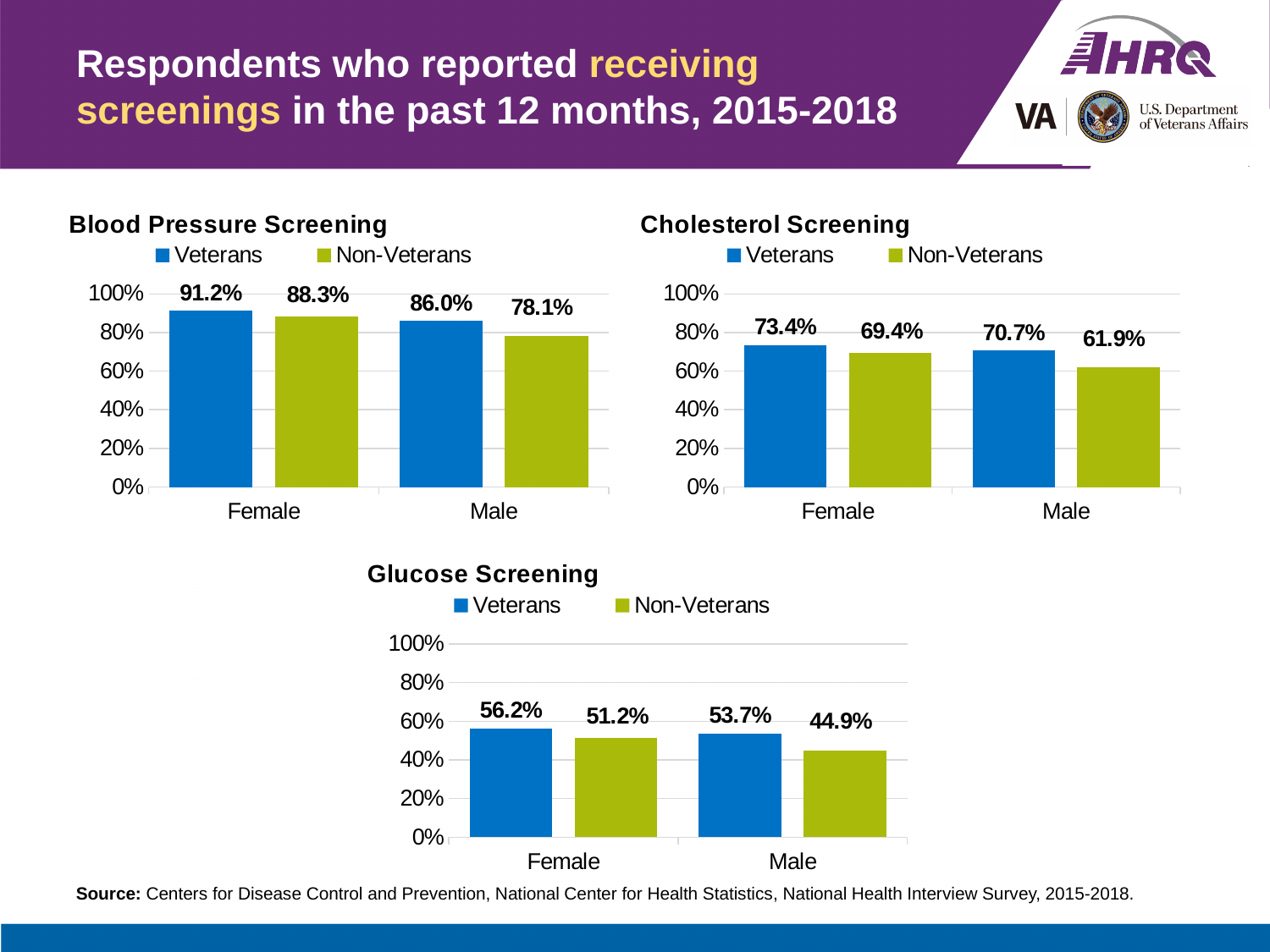
How many charts are shown on the slide? 3 In the Blood Pressure Screening chart, what is the value for Female Veterans? 91.2% In the Glucose Screening chart, what is the value for Female Non-Veterans? 51.2% In the Blood Pressure Screening chart, which bar has the lowest value? Male Non-Veterans In the Glucose Screening chart, is the value for Male Non-Veterans greater or less than 60%? less How many series does the legend of the Cholesterol Screening chart list? 2 In the Cholesterol Screening chart, which is larger: Female Non-Veterans or Male Veterans? Male Veterans In the Blood Pressure Screening chart, what is the difference between Female Veterans and Female Non-Veterans? 2.9% What kind of chart is the Glucose Screening chart? Bar chart In the Cholesterol Screening chart, which bar has the highest value? Female Veterans In the Glucose Screening chart, what is the difference between Male Veterans and Male Non-Veterans? 8.8% In the Cholesterol Screening chart, what is the value for Male Non-Veterans? 61.9%